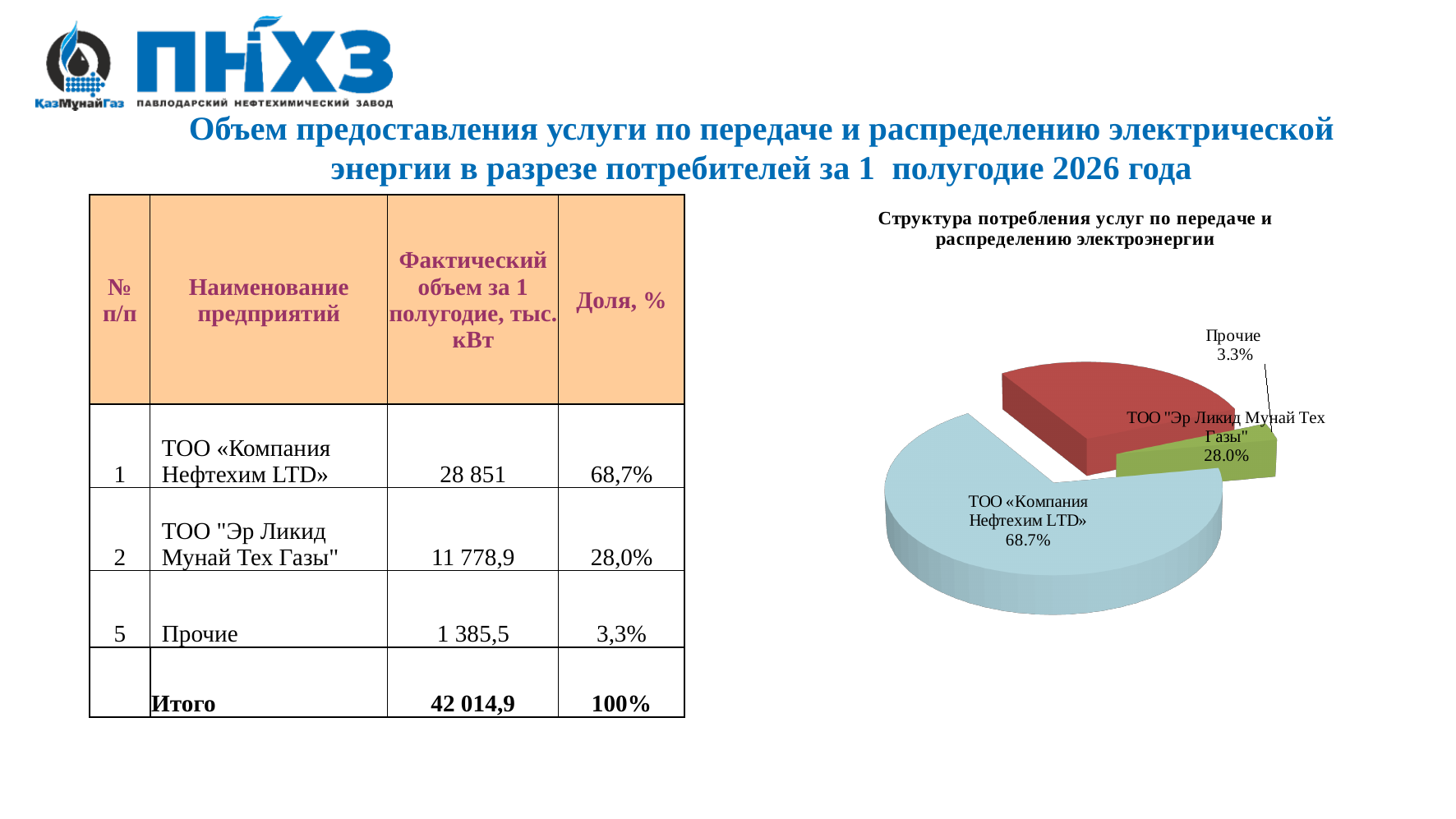
What kind of chart is shown on the slide? Pie chart What colour is the slice for ТОО «Компания Нефтехим LTD» in the pie chart? Light blue Which is larger in the pie chart: the share of ТОО "Эр Ликид Мунай Тех Газы" or the share of Прочие? ТОО "Эр Ликид Мунай Тех Газы" What is the difference in percentage points between the share of ТОО «Компания Нефтехим LTD» and the share of ТОО "Эр Ликид Мунай Тех Газы" in the pie chart? 40.7 What share of the pie chart does ТОО "Эр Ликид Мунай Тех Газы" hold? 28.0% What share of the pie chart does ТОО «Компания Нефтехим LTD» hold? 68.7% What share of the pie chart does Прочие hold? 3.3% Which category has the largest slice in the pie chart? ТОО «Компания Нефтехим LTD» What is the title of the pie chart? Структура потребления услуг по передаче и распределению электроэнергии How many slices does the pie chart have? 3 What is the difference in percentage points between the share of ТОО "Эр Ликид Мунай Тех Газы" and the share of Прочие in the pie chart? 24.7 Which category has the smallest slice in the pie chart? Прочие